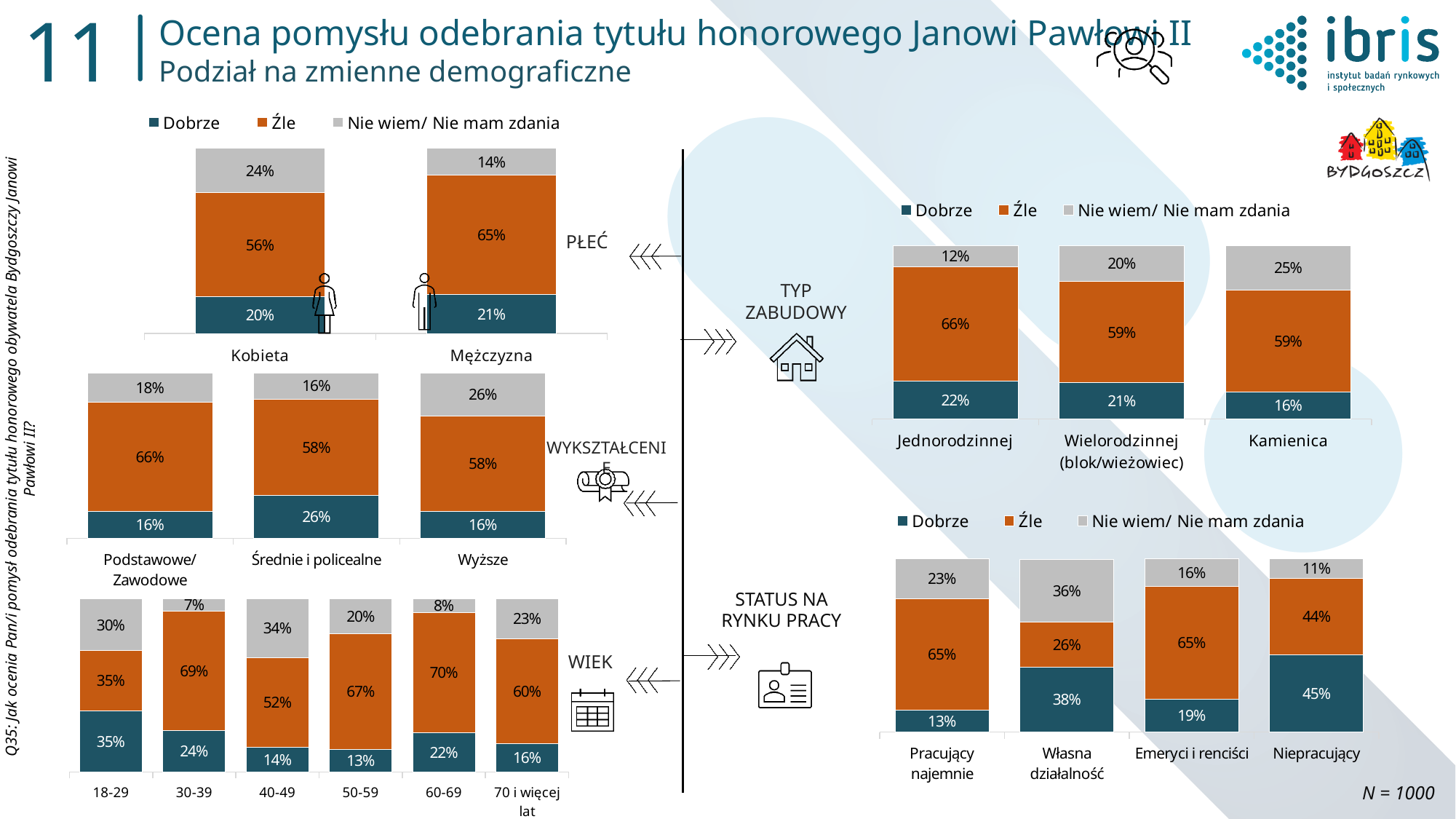
In the WYKSZTAŁCENIE (education) chart, what is the difference between the Źle values for Podstawowe/Zawodowe and Wyższe? 8 percentage points In the STATUS NA RYNKU PRACY (labour market status) chart, which category has the highest Nie wiem/ Nie mam zdania value? Własna działalność In the TYP ZABUDOWY (housing type) chart, is the Dobrze value larger for Jednorodzinnej or Kamienica? Jednorodzinnej In the PŁEĆ (gender) chart, what is the Nie wiem/ Nie mam zdania share for Mężczyzna? 14% In the PŁEĆ (gender) chart, what percentage of Kobieta respondents answered Źle? 56% In the WIEK (age) chart, how many age groups are shown? 6 In the TYP ZABUDOWY (housing type) chart, what is the Źle value for Jednorodzinnej? 66% In the STATUS NA RYNKU PRACY (labour market status) chart, what is the Dobrze value for Niepracujący? 45% In the WIEK (age) chart, which age group has the lowest Nie wiem/ Nie mam zdania value? 30-39 In the WYKSZTAŁCENIE (education) chart, which category has the highest Dobrze value? Średnie i policealne How many series does the legend of the TYP ZABUDOWY chart list? 3 In the WIEK (age) chart, which age group has the highest Dobrze value? 18-29